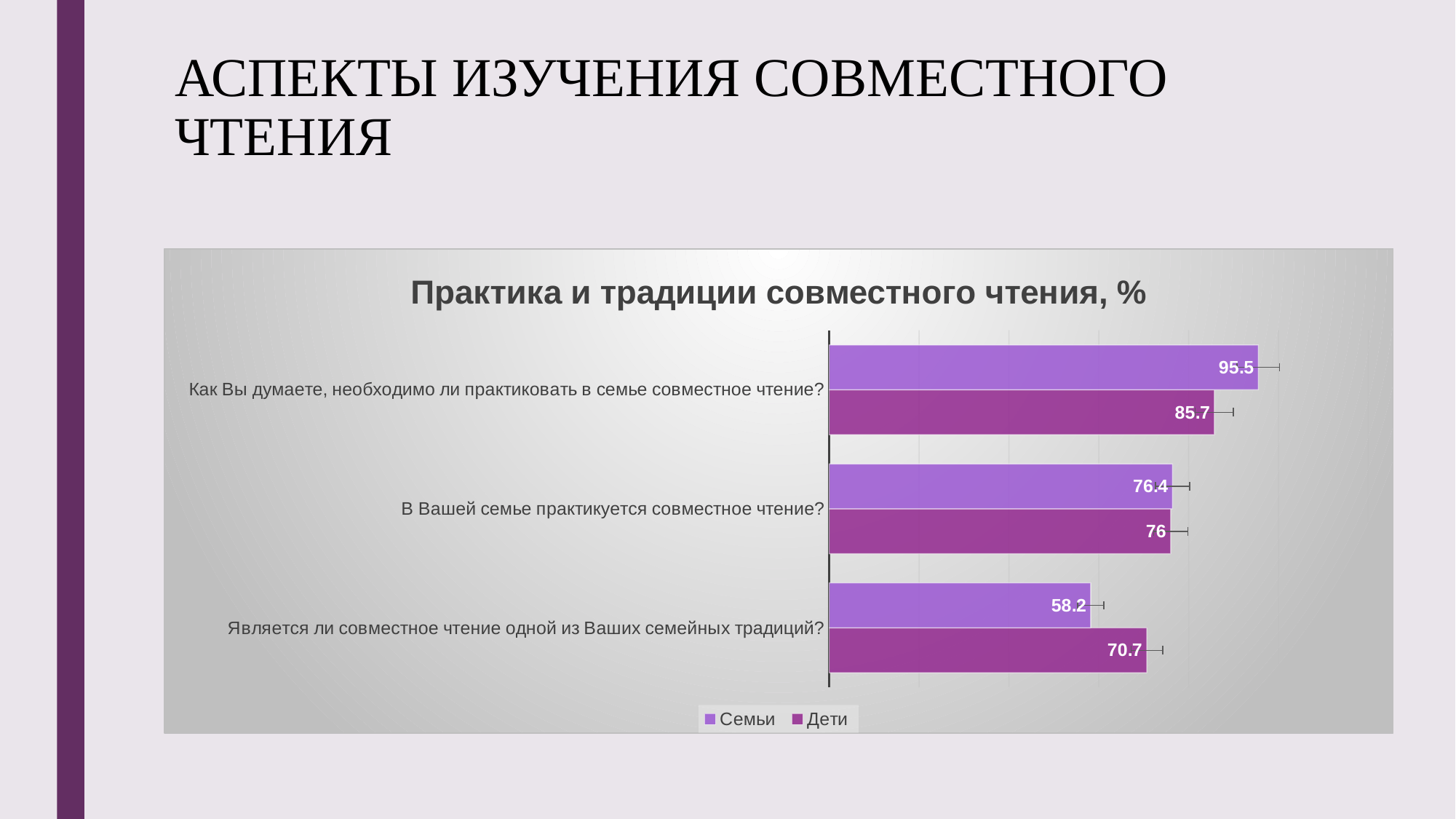
For "Является ли совместное чтение одной из Ваших семейных традиций?", which series has the larger value, Семьи or Дети? Дети What is the value for Семьи on the question "Как Вы думаете, необходимо ли практиковать в семье совместное чтение?"? 95.5 What are the two series named in the legend? Семьи and Дети What is the value for Дети on the question "Является ли совместное чтение одной из Ваших семейных традиций?"? 70.7 Which category has the highest value for the Семьи series? Как Вы думаете, необходимо ли практиковать в семье совместное чтение? How many question categories are shown on the chart? 3 How many series does the legend list? 2 What is the title of the chart? Практика и традиции совместного чтения, % Which category has the lowest value for the Дети series? Является ли совместное чтение одной из Ваших семейных традиций? What type of chart is shown on the slide? Bar chart What is the difference between the Семьи and Дети values for "Как Вы думаете, необходимо ли практиковать в семье совместное чтение?"? 9.8 What is the value for Дети on the question "В Вашей семье практикуется совместное чтение?"? 76